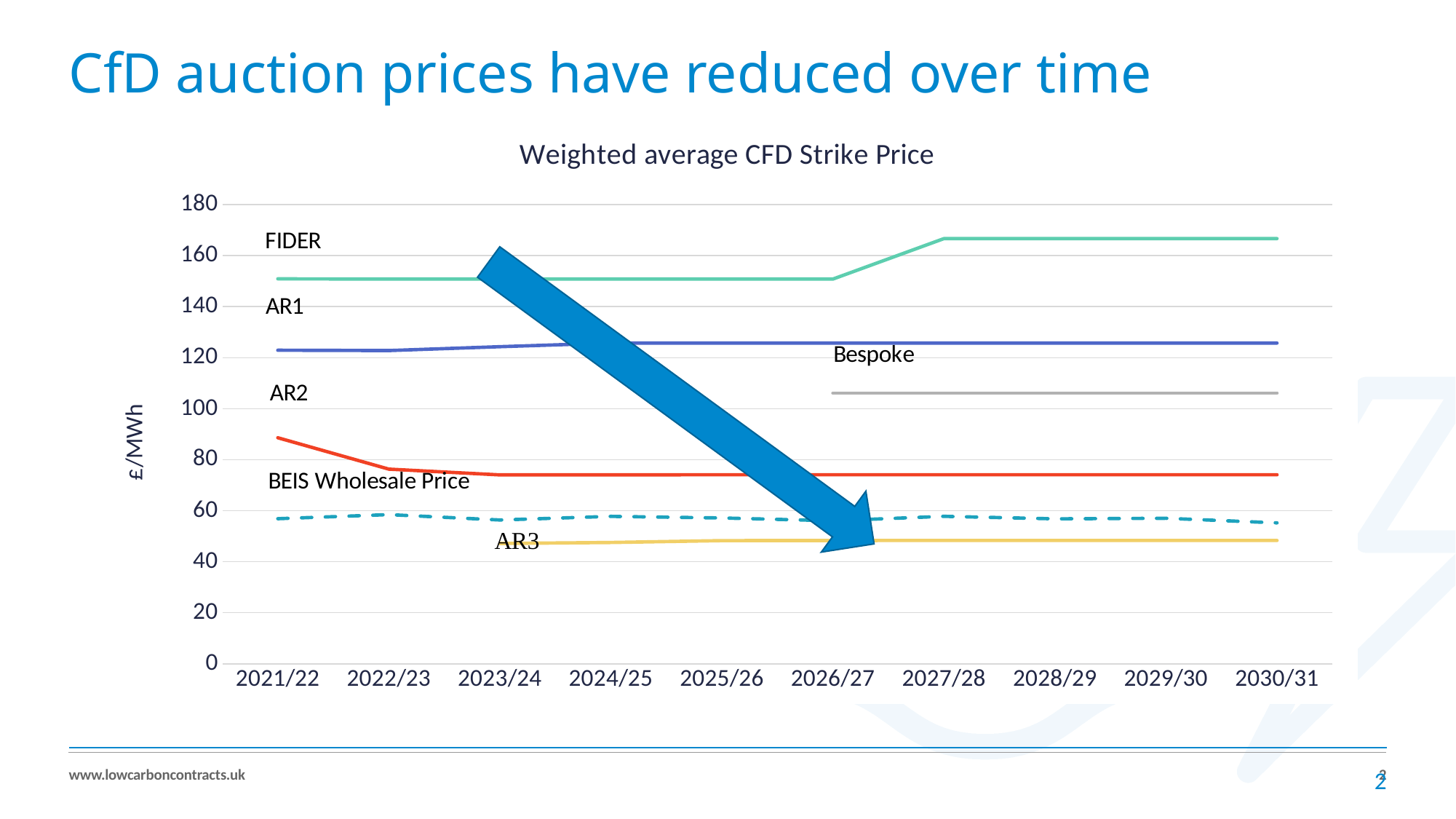
How many years are shown along the x axis of the chart? 10 What is the title of the chart? Weighted average CFD Strike Price Does the AR2 line rise or fall between 2021/22 and 2023/24? fall Which is larger in 2030/31, AR1 or AR2? AR1 Which series has the lowest values on the chart? AR3 What unit is shown on the vertical axis of the chart? £/MWh What kind of chart is shown on the slide? line chart How many labelled series (lines) are plotted on the chart? 6 Is the value for AR3 in 2030/31 greater or less than 60? less Is the value for FIDER in 2021/22 greater or less than 140? greater Is the value for AR2 in 2021/22 greater or less than 80? greater Which series has the highest strike price across the chart? FIDER